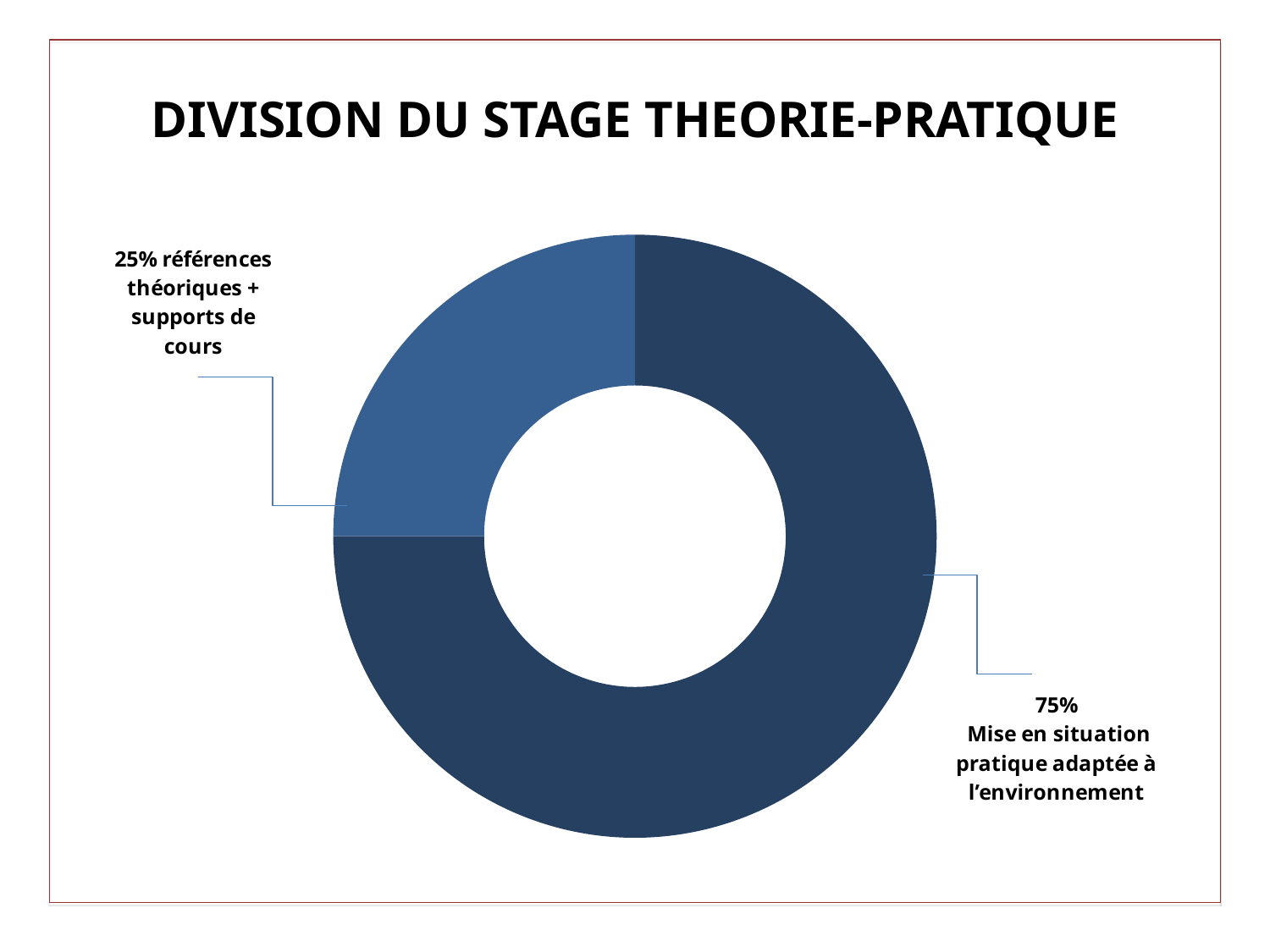
What share of the chart is 'Mise en situation pratique adaptée à l'environnement'? 75% Which slice is the smallest? références théoriques + supports de cours Is the share for 'références théoriques + supports de cours' greater or less than 50%? less Which slice is the largest? Mise en situation pratique adaptée à l'environnement How many slices does the chart have? 2 What is the title of the chart? DIVISION DU STAGE THEORIE-PRATIQUE Which slice is drawn in the darker blue colour? Mise en situation pratique adaptée à l'environnement What kind of chart is shown on the slide? Doughnut (pie) chart What share of the chart is 'références théoriques + supports de cours'? 25% What is the difference in percentage points between the practical slice and the theoretical slice? 50 Which is larger: the share for 'Mise en situation pratique' or the share for 'références théoriques + supports de cours'? Mise en situation pratique